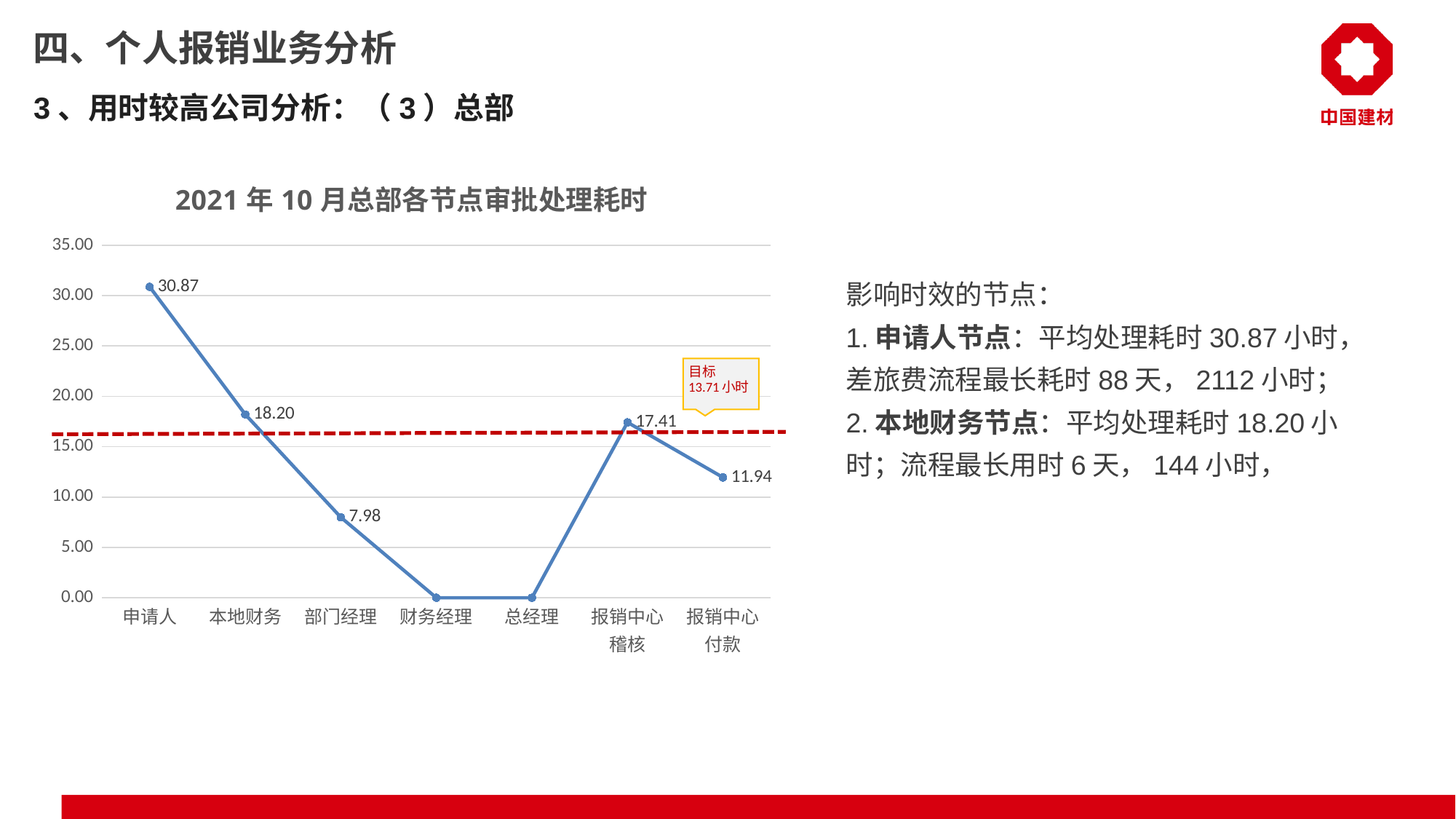
What is the title of the chart? 2021年10月总部各节点审批处理耗时 What is the value for 本地财务 in the chart? 18.20 What is the difference between the values for 申请人 and 本地财务? 12.67 What is the value for 申请人 in the chart? 30.87 What target value is shown in the callout next to the red dashed line? 13.71小时 Which is larger, the value for 本地财务 or the value for 报销中心稽核? 本地财务 What type of chart is shown on the slide? Line chart What is the value for 报销中心稽核 in the chart? 17.41 How many nodes (categories) are plotted on the x axis of the chart? 7 Is the value for 财务经理 greater or less than 5.00? less What is the value for 报销中心付款 in the chart? 11.94 Which node has the highest value in the chart? 申请人